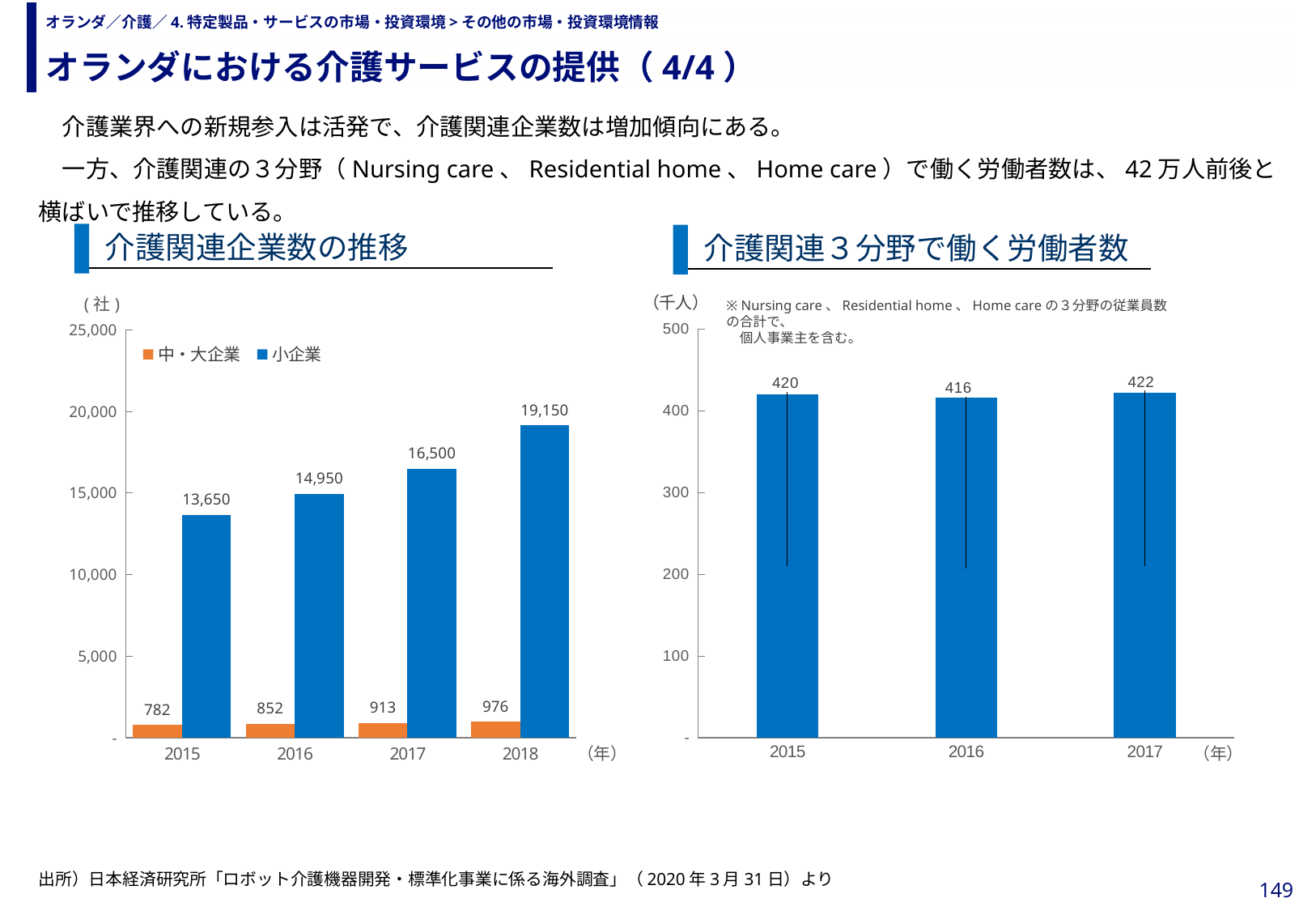
In the chart titled 介護関連企業数の推移, what colour are the 中・大企業 bars? orange In the chart titled 介護関連３分野で働く労働者数, which year has the lowest value? 2016 In the chart titled 介護関連企業数の推移, what is the value for 小企業 in 2018? 19,150 What kind of chart is the chart titled 介護関連３分野で働く労働者数? bar chart In the chart titled 介護関連企業数の推移, what is the difference between the 小企業 values for 2018 and 2017? 2,650 In the chart titled 介護関連企業数の推移, how many series does the legend list? 2 In the chart titled 介護関連企業数の推移, which year has the highest value for 小企業? 2018 In the chart titled 介護関連企業数の推移, what is the value for 中・大企業 in 2015? 782 In the chart titled 介護関連企業数の推移, do the 中・大企業 values rise or fall from 2015 to 2018? rise In the chart titled 介護関連３分野で働く労働者数, what is the difference between the values for 2017 and 2015? 2 In the chart titled 介護関連３分野で働く労働者数, what is the value for 2016? 416 In the chart titled 介護関連３分野で働く労働者数, how many years are plotted? 3